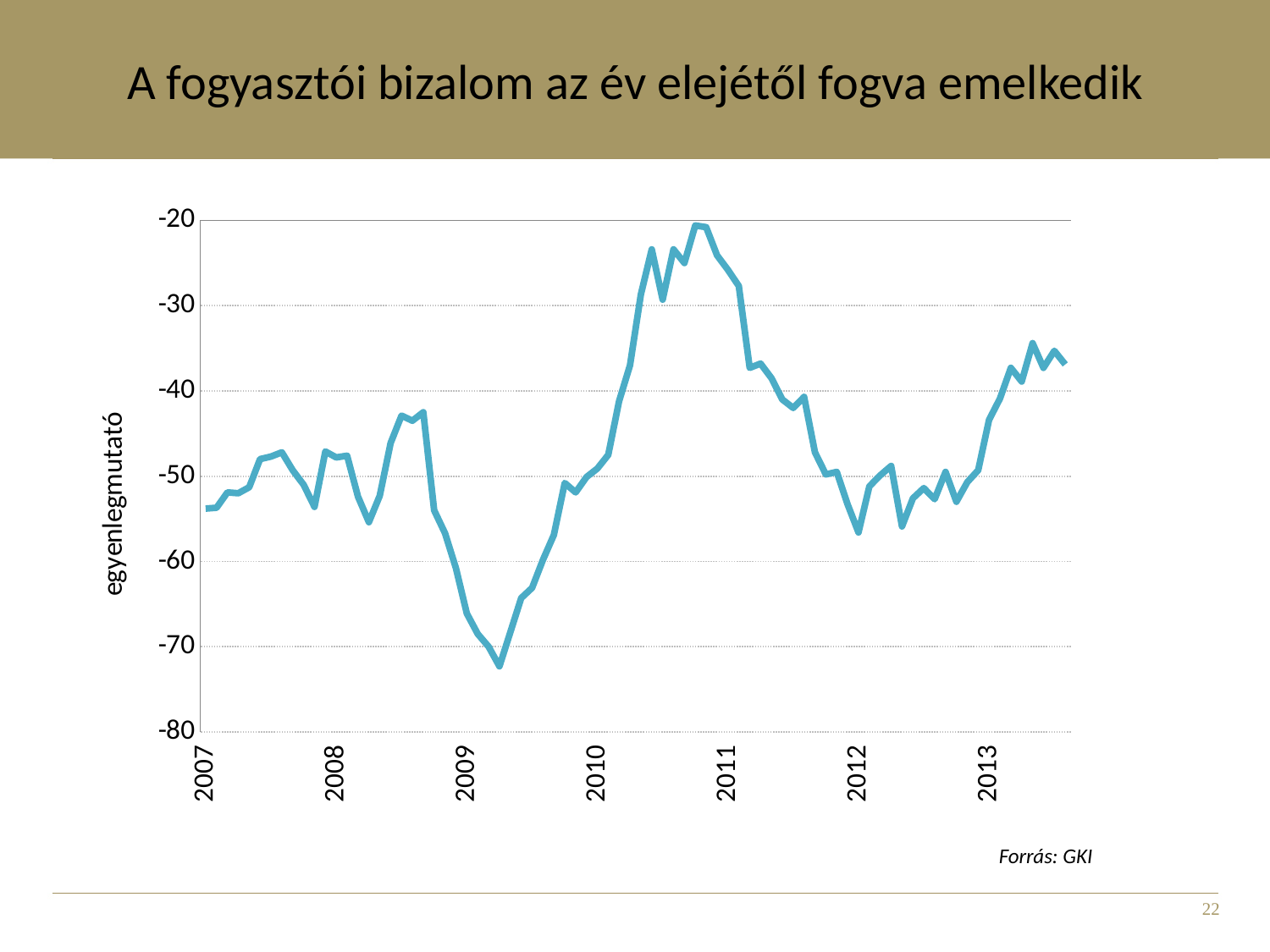
Is the value at the start of 2007 greater or less than -50? less Is the value at the start of 2012 greater or less than -50? less Does the line rise or fall between the start of 2011 and the start of 2012? fall What kind of chart is shown on the slide? line chart Is the lowest point of the line greater or less than -70? less In which year does the line reach its lowest point? 2009 How many year labels are shown on the horizontal axis? 7 Does the line rise or fall between the start of 2012 and the end of the series in 2013? rise What is the title of the chart on the slide? A fogyasztói bizalom az év elejétől fogva emelkedik In which year does the line reach its highest point? 2010 What is the label on the vertical axis of the chart? egyenlegmutató